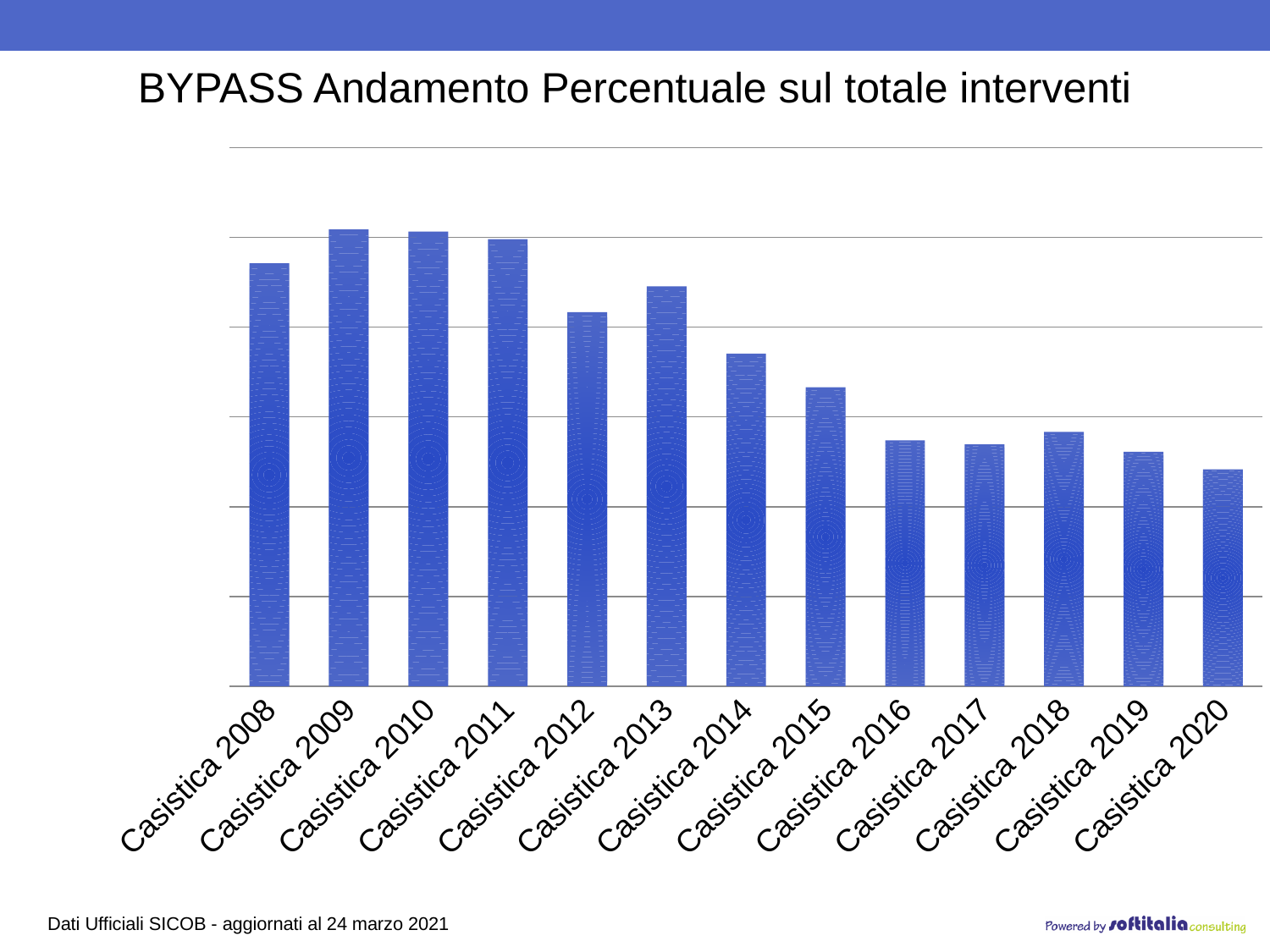
Which is larger, the value for Casistica 2011 or the value for Casistica 2012? Casistica 2011 Which is larger, the value for Casistica 2014 or the value for Casistica 2015? Casistica 2014 Which is larger, the value for Casistica 2008 or the value for Casistica 2013? Casistica 2008 What kind of chart is shown on the slide? bar chart Which category has the lowest bar on the chart? Casistica 2020 How many categories (years) are plotted on the chart? 13 Do the values generally rise or fall from Casistica 2009 to Casistica 2020? fall What is the title of the chart? BYPASS Andamento Percentuale sul totale interventi What colour are the bars in the chart? blue